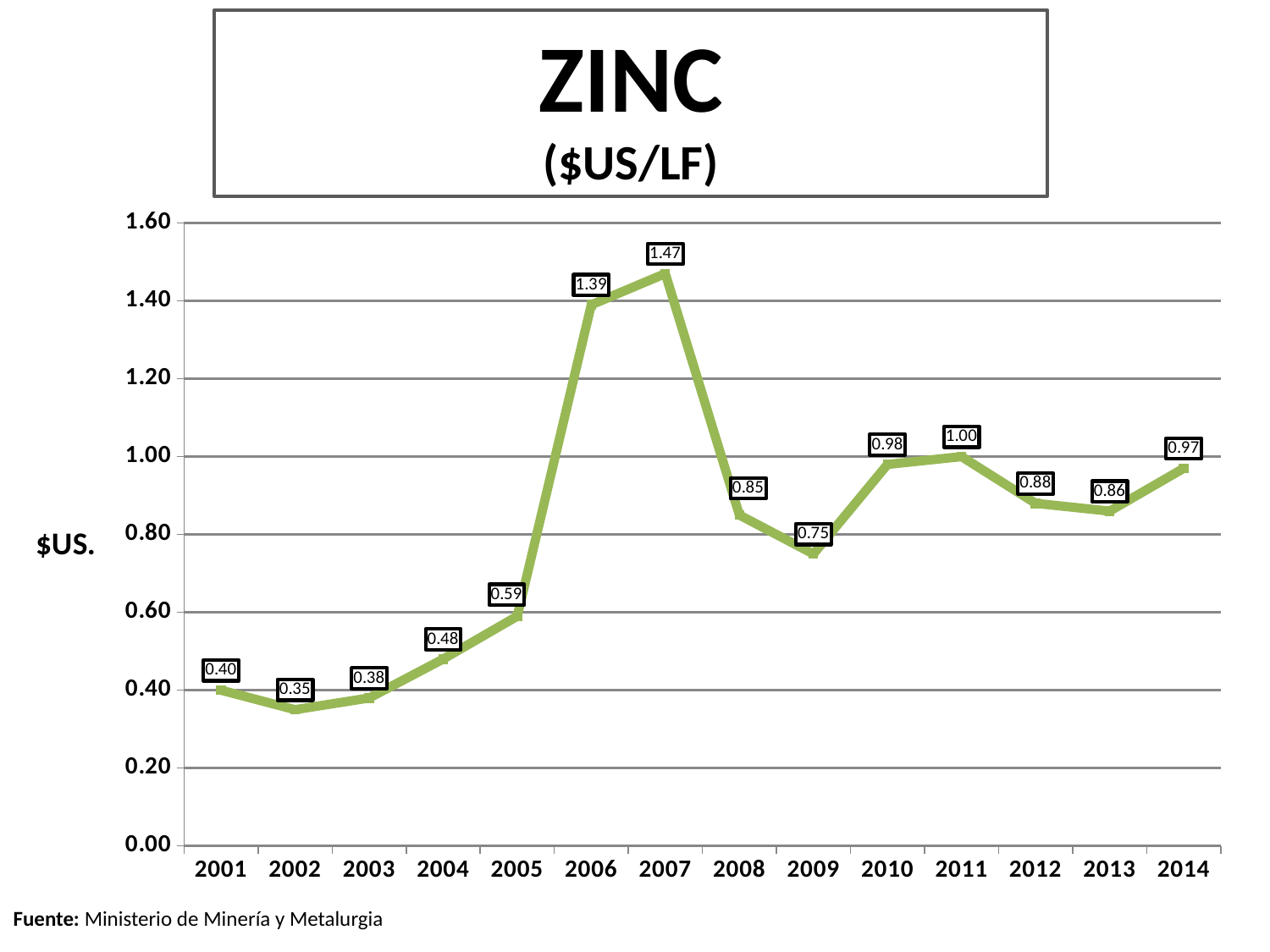
What is the zinc price value for 2007? 1.47 Which year has a higher zinc price, 2008 or 2012? 2012 What kind of chart is shown on the slide? line chart Which year has the lowest zinc price? 2002 Is the zinc price for 2005 greater or less than 0.80? less What is the zinc price value for 2011? 1.00 Which year has the highest zinc price? 2007 Does the zinc price rise or fall from 2001 to 2007? rise What is the difference between the zinc price in 2010 and in 2009? 0.23 What is the zinc price value for 2002? 0.35 What is the difference between the zinc price in 2007 and in 2006? 0.08 How many years are plotted on the chart? 14